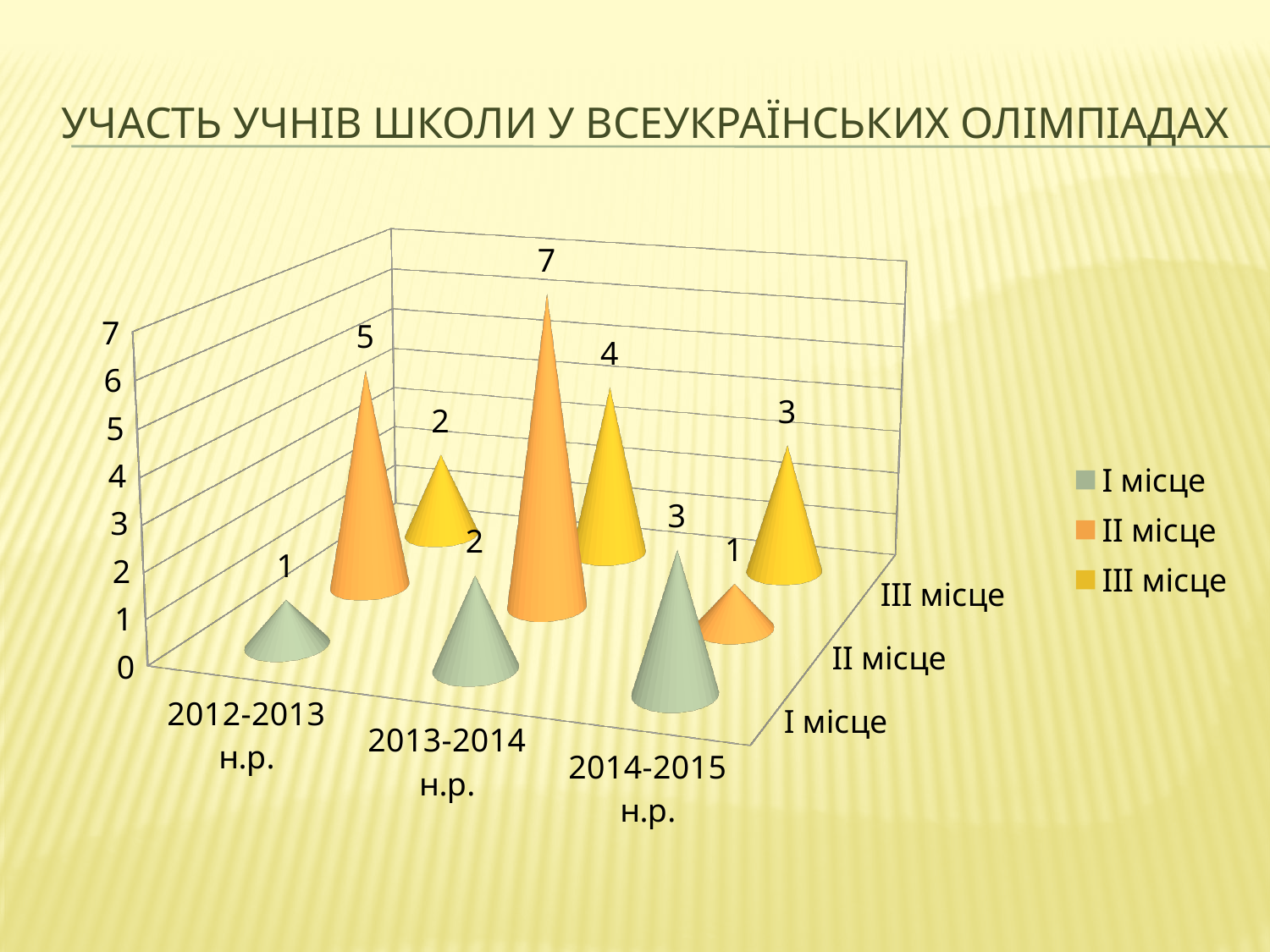
What is the value for III місце in 2014-2015 н.р.? 3 What is the value for II місце in 2013-2014 н.р.? 7 What is the title of the chart on the slide? УЧАСТЬ УЧНІВ ШКОЛИ У ВСЕУКРАЇНСЬКИХ ОЛІМПІАДАХ How many series does the legend list? 3 Does the value for I місце rise or fall from 2012-2013 н.р. to 2014-2015 н.р.? rise Which year has the highest value for II місце? 2013-2014 н.р. How many school years are shown on the x axis? 3 What is the value for II місце in 2014-2015 н.р.? 1 What is the value for I місце in 2012-2013 н.р.? 1 What is the difference between the II місце values for 2013-2014 н.р. and 2012-2013 н.р.? 2 Which is larger: III місце in 2013-2014 н.р. or III місце in 2012-2013 н.р.? III місце in 2013-2014 н.р. Which year has the lowest value for I місце? 2012-2013 н.р.